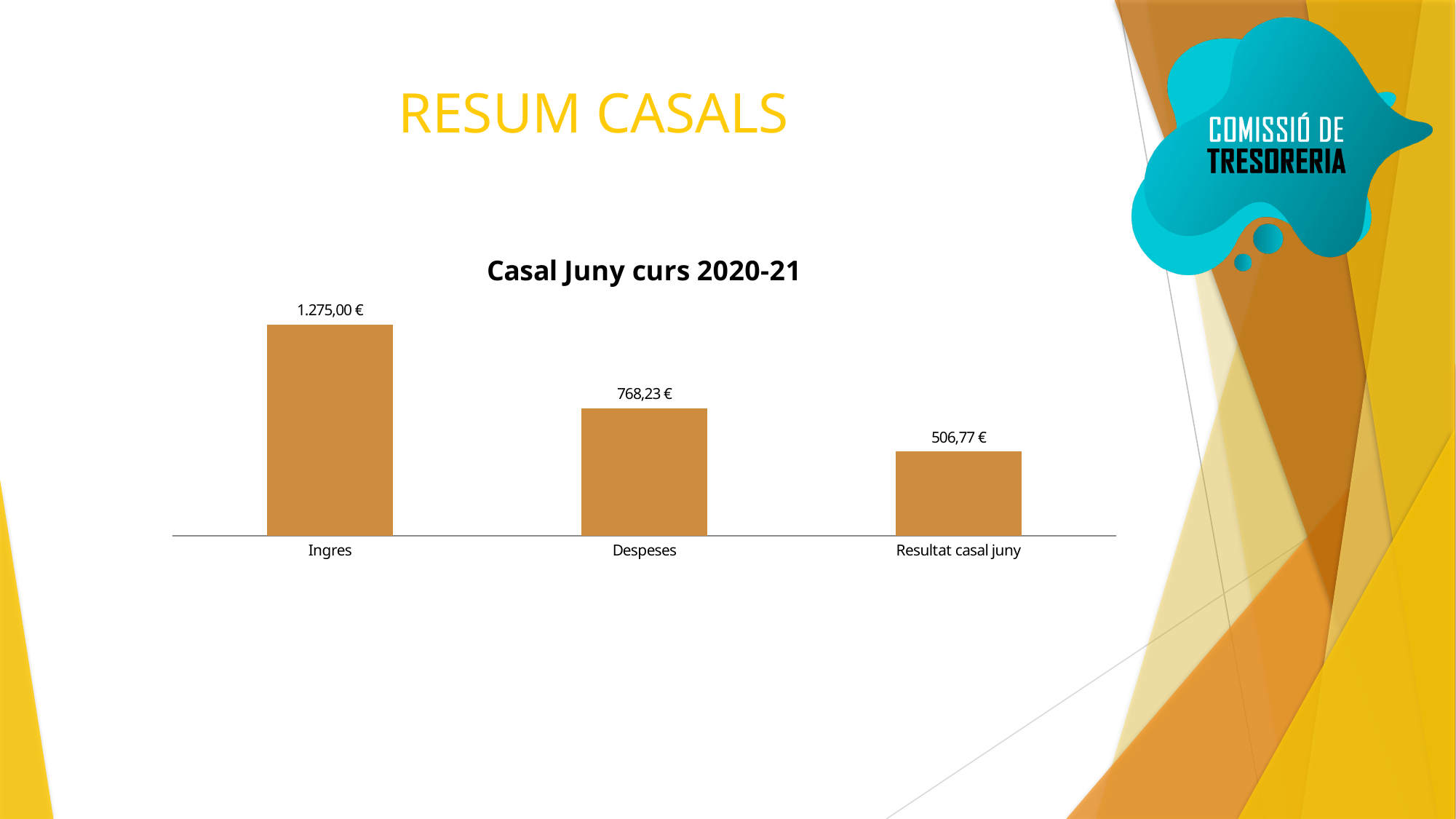
What is the value for Despeses? 768,23 € Which category has the highest value? Ingres What is the value for Ingres? 1.275,00 € What kind of chart is shown? Bar chart How many categories are shown in the chart? 3 Which is larger, Despeses or Resultat casal juny? Despeses What is the value for Resultat casal juny? 506,77 € What is the title of the chart? Casal Juny curs 2020-21 What is the difference between Despeses and Resultat casal juny? 261,46 € Do the values rise or fall from left to right along the x axis? Fall Which category has the lowest value? Resultat casal juny What is the difference between Ingres and Despeses? 506,77 €